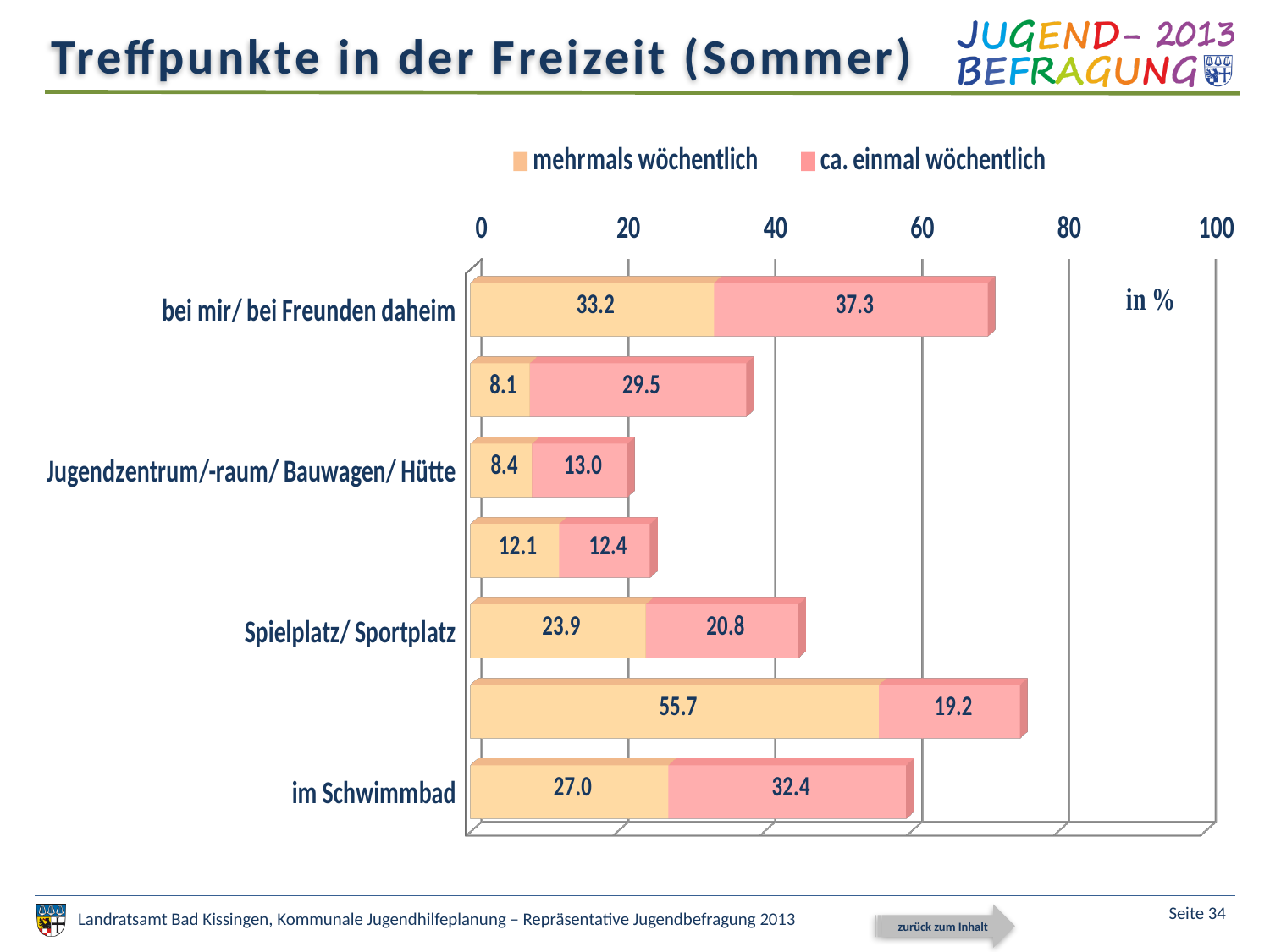
What is the value for "mehrmals wöchentlich" for "bei mir/ bei Freunden daheim"? 33.2 What is the value for "ca. einmal wöchentlich" for "Jugendzentrum/-raum/ Bauwagen/ Hütte"? 13.0 What is the value for "ca. einmal wöchentlich" for "im Schwimmbad"? 32.4 What is the total of the stacked bar for "bei mir/ bei Freunden daheim"? 70.5 What is the difference between the "ca. einmal wöchentlich" and "mehrmals wöchentlich" values for "im Schwimmbad"? 5.4 How many series does the legend list? 2 What kind of chart is shown on the slide? stacked bar chart What is the total of the stacked bar for "im Schwimmbad"? 59.4 What is the value for "mehrmals wöchentlich" for "Spielplatz/ Sportplatz"? 23.9 Which is larger for "Spielplatz/ Sportplatz": "mehrmals wöchentlich" or "ca. einmal wöchentlich"? mehrmals wöchentlich Is the total of the stacked bar for "Jugendzentrum/-raum/ Bauwagen/ Hütte" greater or less than 40? less How many bars are plotted in the chart? 7